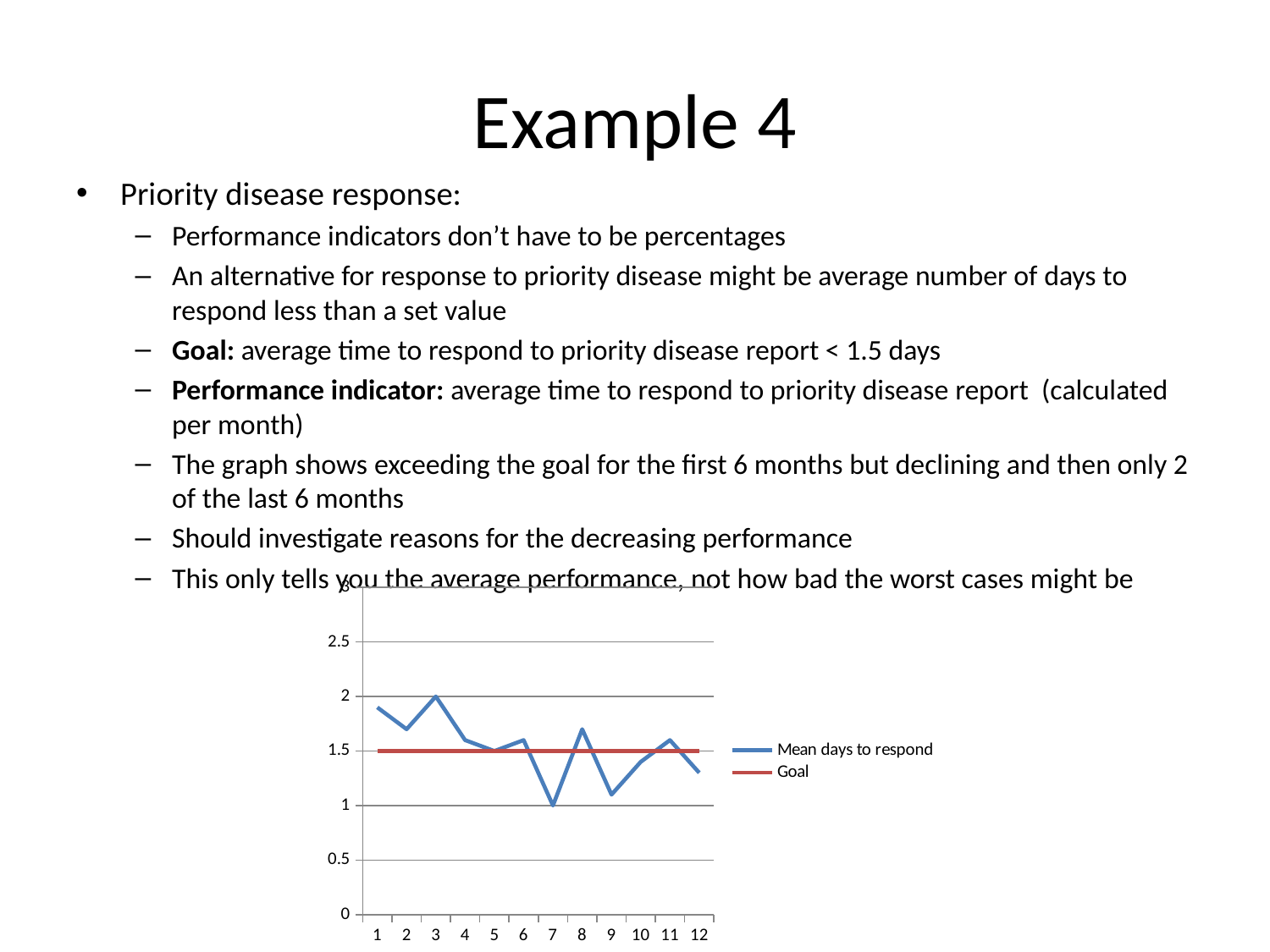
How many series does the chart's legend list? 2 Which month has the lowest Mean days to respond? 7 Which is larger, the Mean days to respond for month 1 or for month 12? month 1 Is the Mean days to respond for month 9 greater or less than 1.5? less What kind of chart is shown on the slide? line chart How many months (points) are plotted along the x axis? 12 What value does the Goal line sit at? 1.5 Which month has the highest Mean days to respond? 3 Is the Mean days to respond for month 1 greater or less than 1.5? greater What is the value of Mean days to respond for month 7? 1 What is the value of Mean days to respond for month 3? 2 What colour is the Goal line in the chart? red